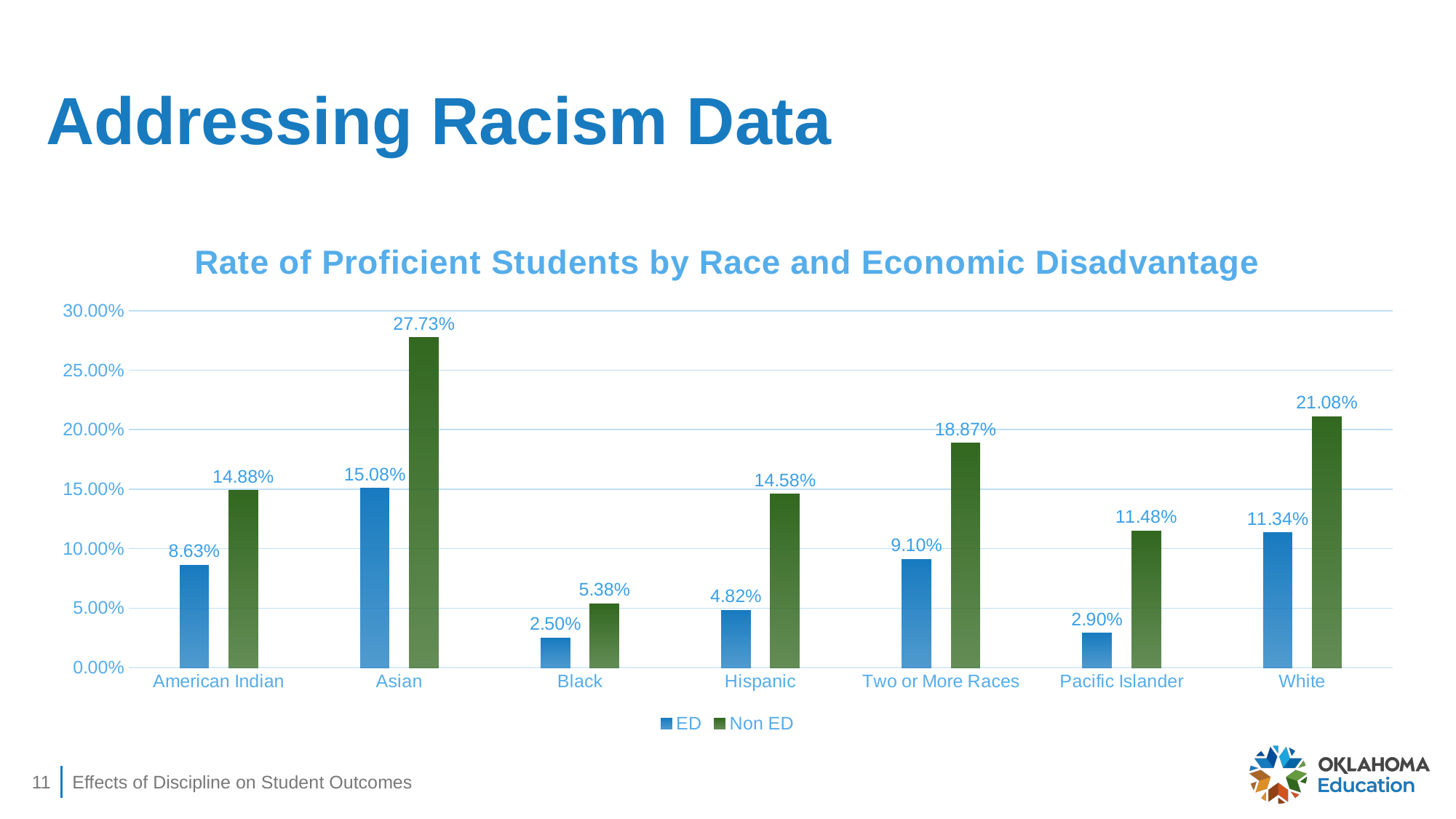
What type of chart is shown on the slide? Bar chart What is the ED value for Pacific Islander? 2.90% What is the ED value for Asian? 15.08% Which is larger, the Non ED value for Hispanic or the Non ED value for American Indian? American Indian What is the difference between the Non ED and ED values for Asian? 12.65% Which category has the highest Non ED value? Asian What is the difference between the Non ED and ED values for White? 9.74% Which category has the lowest ED value? Black What is the Non ED value for White? 21.08% How many race categories are shown on the x axis? 7 How many series does the legend list? 2 Is the Non ED value for Two or More Races greater or less than 15.00%? greater